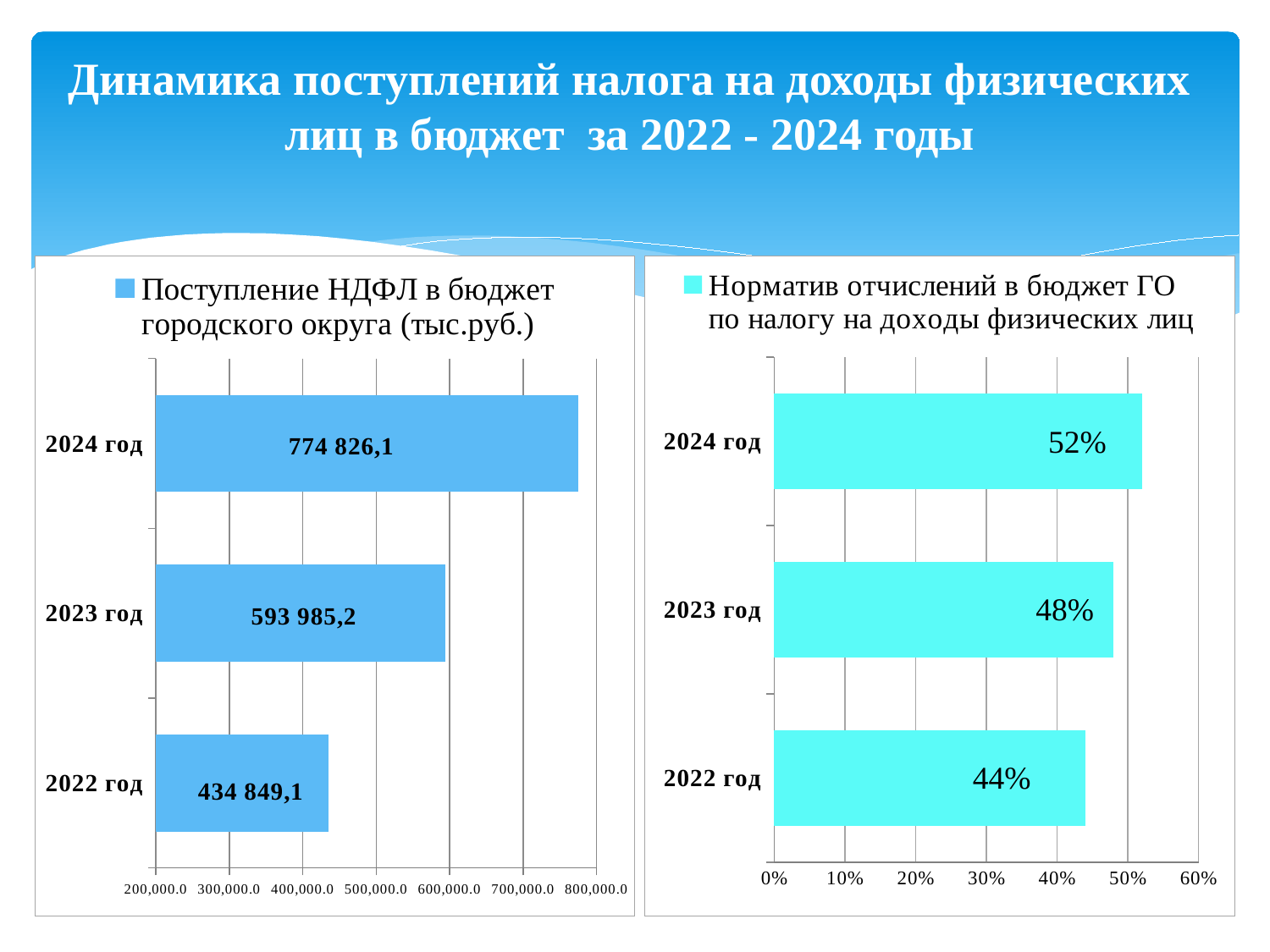
In the left chart (Поступление НДФЛ в бюджет городского округа), which year has the lowest value? 2022 год In the right chart (Норматив отчислений в бюджет ГО), what is the value for 2023 год? 48% In the left chart (Поступление НДФЛ в бюджет городского округа), which is larger: the value for 2023 год or 2022 год? 2023 год In the left chart (Поступление НДФЛ в бюджет городского округа), what is the value for 2024 год? 774 826,1 How many years are shown in the right chart (Норматив отчислений в бюджет ГО)? 3 In the right chart (Норматив отчислений в бюджет ГО), do the values rise or fall from 2022 год to 2024 год? rise What kind of chart is the left chart (Поступление НДФЛ в бюджет городского округа)? bar chart In the left chart (Поступление НДФЛ в бюджет городского округа), is the value for 2023 год greater or less than 500,000.0? greater In the left chart (Поступление НДФЛ в бюджет городского округа), what is the difference between the values for 2024 год and 2023 год? 180 840,9 In the left chart (Поступление НДФЛ в бюджет городского округа), what is the value for 2022 год? 434 849,1 In the right chart (Норматив отчислений в бюджет ГО), what is the difference between the values for 2024 год and 2022 год? 8% In the right chart (Норматив отчислений в бюджет ГО), which year has the highest value? 2024 год